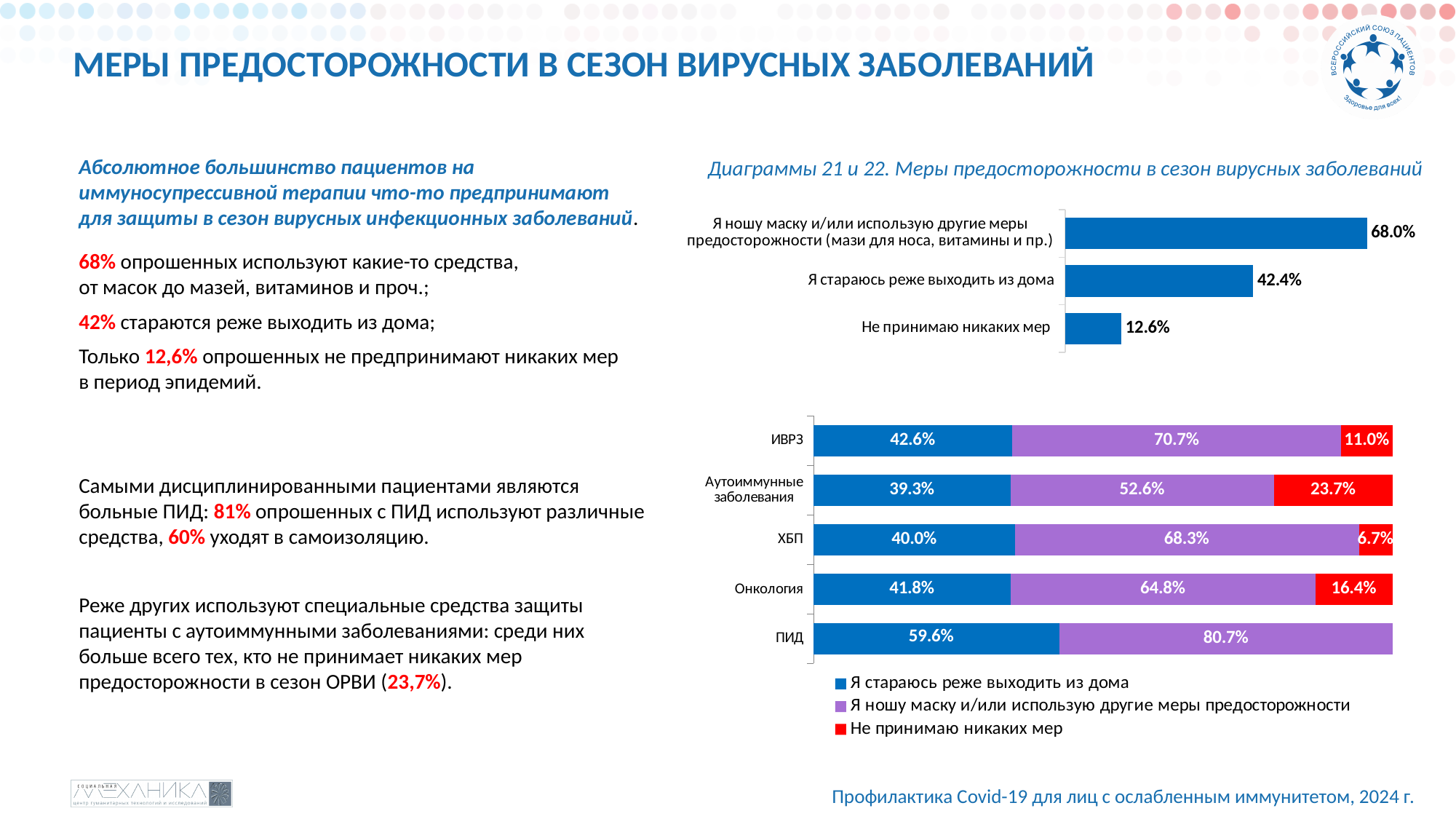
In the top chart, what is the difference between the value for "Я ношу маску и/или использую другие меры предосторожности" and the value for "Не принимаю никаких мер"? 55.4 percentage points In the top chart, which category has the highest value? Я ношу маску и/или использую другие меры предосторожности (мази для носа, витамины и пр.) How many series does the legend of the bottom chart list? 3 In the bottom chart, which is larger in the series "Я ношу маску и/или использую другие меры предосторожности": ХБП or Онкология? ХБП In the bottom chart, which category has the highest value in the series "Не принимаю никаких мер"? Аутоиммунные заболевания What kind of chart is the top chart? Bar chart In the bottom chart, what is the value for "Аутоиммунные заболевания" in the series "Не принимаю никаких мер"? 23.7% In the top chart, which category has the lowest value? Не принимаю никаких мер How many categories are shown in the top chart? 3 In the bottom chart, what is the difference between ПИД and ИВРЗ in the series "Я стараюсь реже выходить из дома"? 17.0 percentage points In the bottom chart, what is the value for ПИД in the series "Я ношу маску и/или использую другие меры предосторожности"? 80.7% In the top chart, what is the value for "Я стараюсь реже выходить из дома"? 42.4%